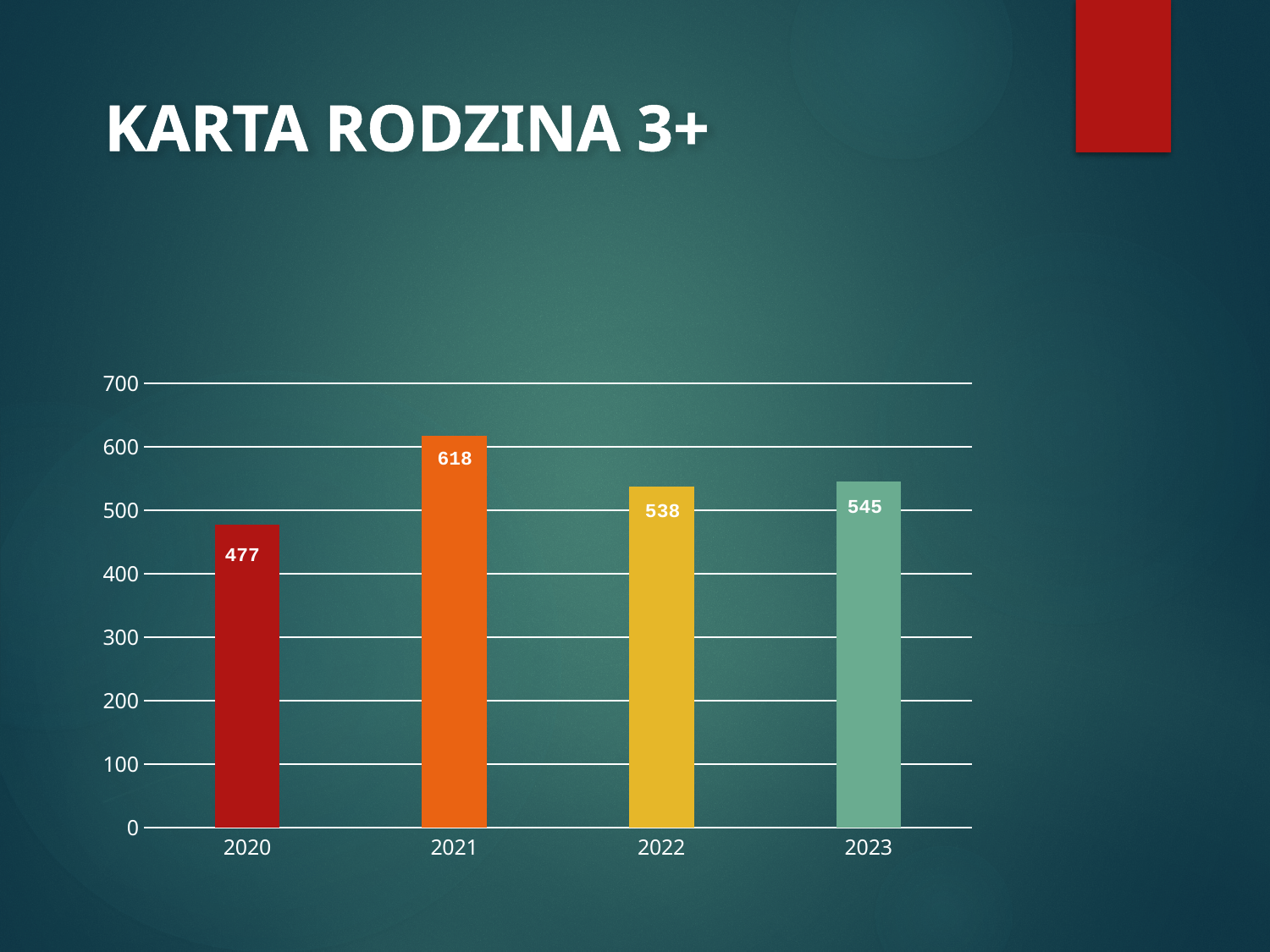
How many years are shown on the x axis? 4 Which year has the highest value? 2021 What is the value for 2020? 477 What is the difference between the values for 2023 and 2022? 7 Which year has the lowest value? 2020 What is the value for 2023? 545 What is the difference between the values for 2021 and 2020? 141 Which is larger, the value for 2020 or the value for 2022? 2022 What is the value for 2022? 538 What is the value for 2021? 618 Is the value for 2021 greater or less than 600? greater What kind of chart is shown on the slide? bar chart